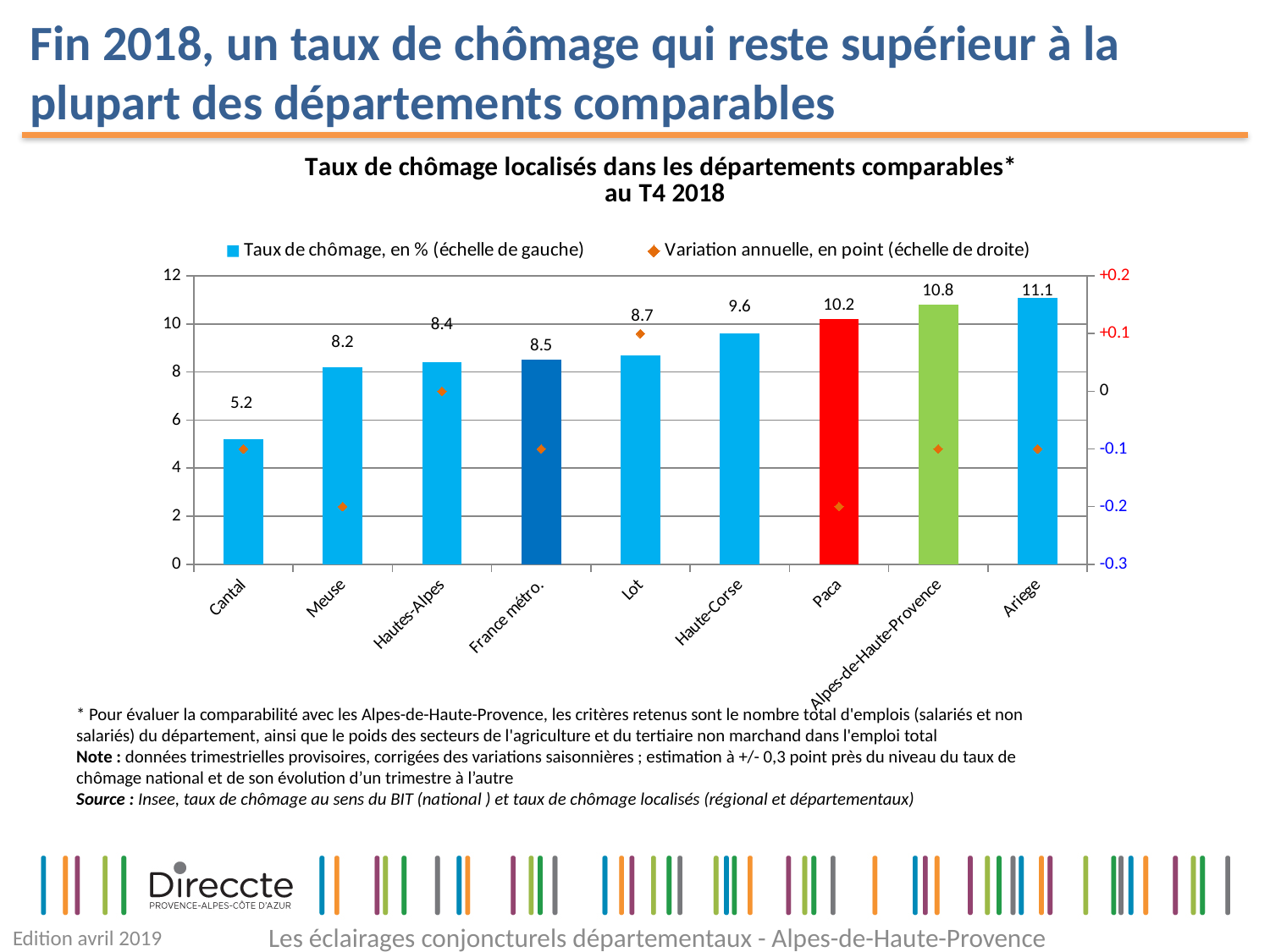
Which department has the lowest unemployment rate in the chart? Cantal Which has a higher unemployment rate, Paca or Haute-Corse? Paca Which department has the highest unemployment rate in the chart? Ariege What is the unemployment rate shown for France métro.? 8.5 How many departments or areas are shown on the x axis? 9 What is the unemployment rate shown for Cantal? 5.2 How many series does the legend list? 2 What type of chart is used to show the unemployment rates? bar chart Is the annual variation (right axis) for Meuse greater or less than -0.1? less What is the unemployment rate shown for Alpes-de-Haute-Provence? 10.8 What is the difference between the unemployment rates of Ariege and Cantal? 5.9 What is the difference between the unemployment rates of Alpes-de-Haute-Provence and France métro.? 2.3